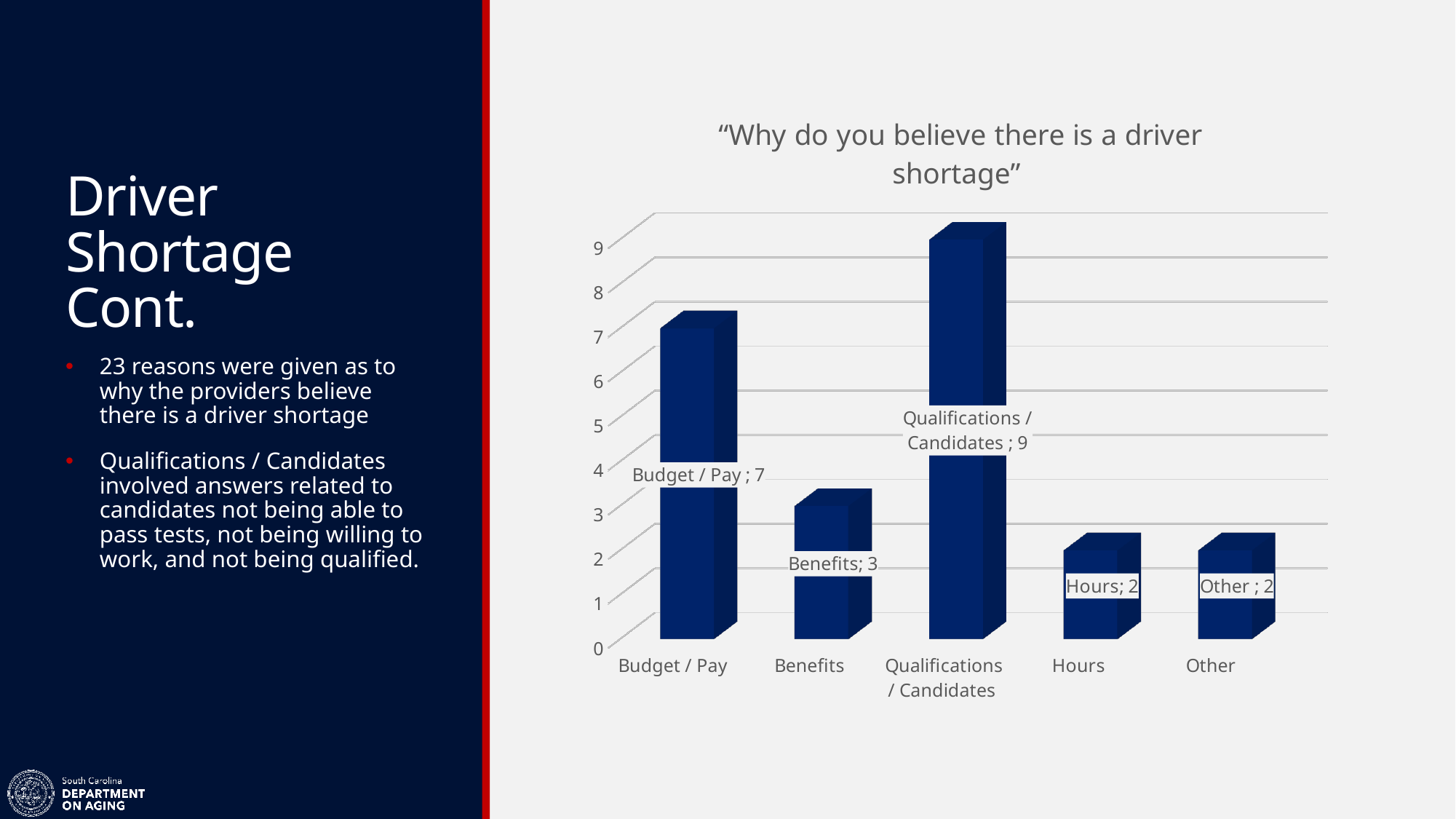
What is the value for Benefits? 3 Is the value for Budget / Pay greater or less than 5? greater What is the difference between the values for Qualifications / Candidates and Budget / Pay? 2 Which category has the highest value? Qualifications / Candidates What is the total of all the values shown in the chart? 23 What is the title of the chart? “Why do you believe there is a driver shortage” What is the value for Qualifications / Candidates? 9 What kind of chart is shown on the slide? bar chart What is the value for Hours? 2 How many categories are shown on the x axis? 5 Which is larger, the value for Benefits or the value for Hours? Benefits What is the value for Budget / Pay? 7